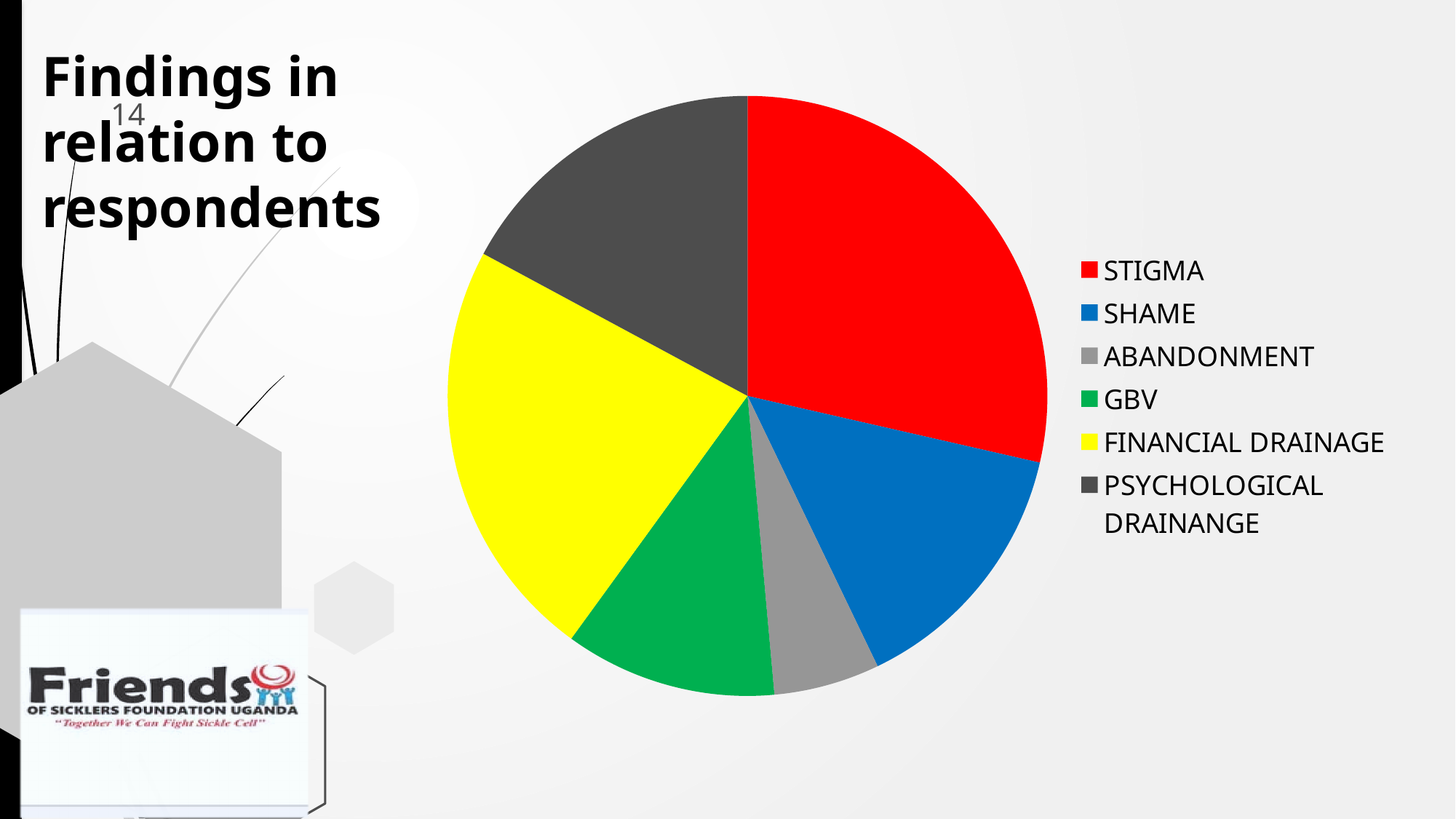
What kind of chart is shown on the slide? pie chart Which slice is larger, STIGMA or SHAME? STIGMA How many entries does the legend of the pie chart list? 6 What colour is the STIGMA slice in the pie chart? red Which category is shown in yellow in the pie chart? FINANCIAL DRAINAGE Which category has the smallest slice of the pie chart? ABANDONMENT How many categories does the pie chart have? 6 Which slice is larger, PSYCHOLOGICAL DRAINANGE or ABANDONMENT? PSYCHOLOGICAL DRAINANGE Which category has the largest slice of the pie chart? STIGMA Which slice is larger, STIGMA or FINANCIAL DRAINAGE? STIGMA